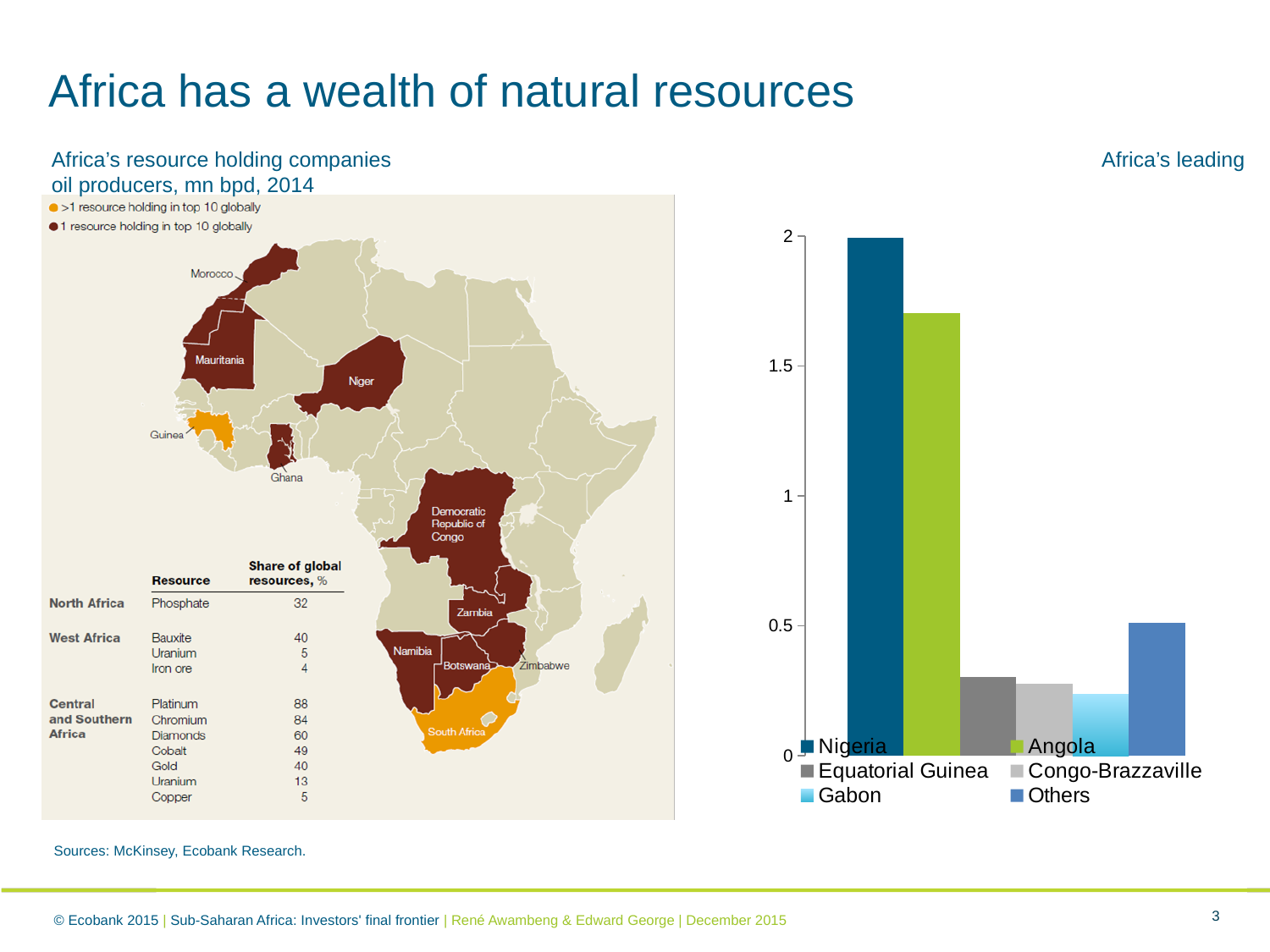
What colour is the Angola bar in the oil producers chart? green In the oil producers chart, is the value for Angola greater or less than 1.5? greater In the oil producers chart, which is larger, Nigeria or Angola? Nigeria What unit is given in the title of the oil producers chart? mn bpd Which country has the highest bar in the oil producers chart? Nigeria In the oil producers chart, is the value for Nigeria greater or less than 1.5? greater How many series does the legend of the oil producers chart list? 6 Which country has the lowest bar in the oil producers chart? Gabon In the oil producers chart, is the value for Others greater or less than 1? less In the oil producers chart, which is larger, Others or Equatorial Guinea? Others What kind of chart is used to show Africa's leading oil producers? bar chart